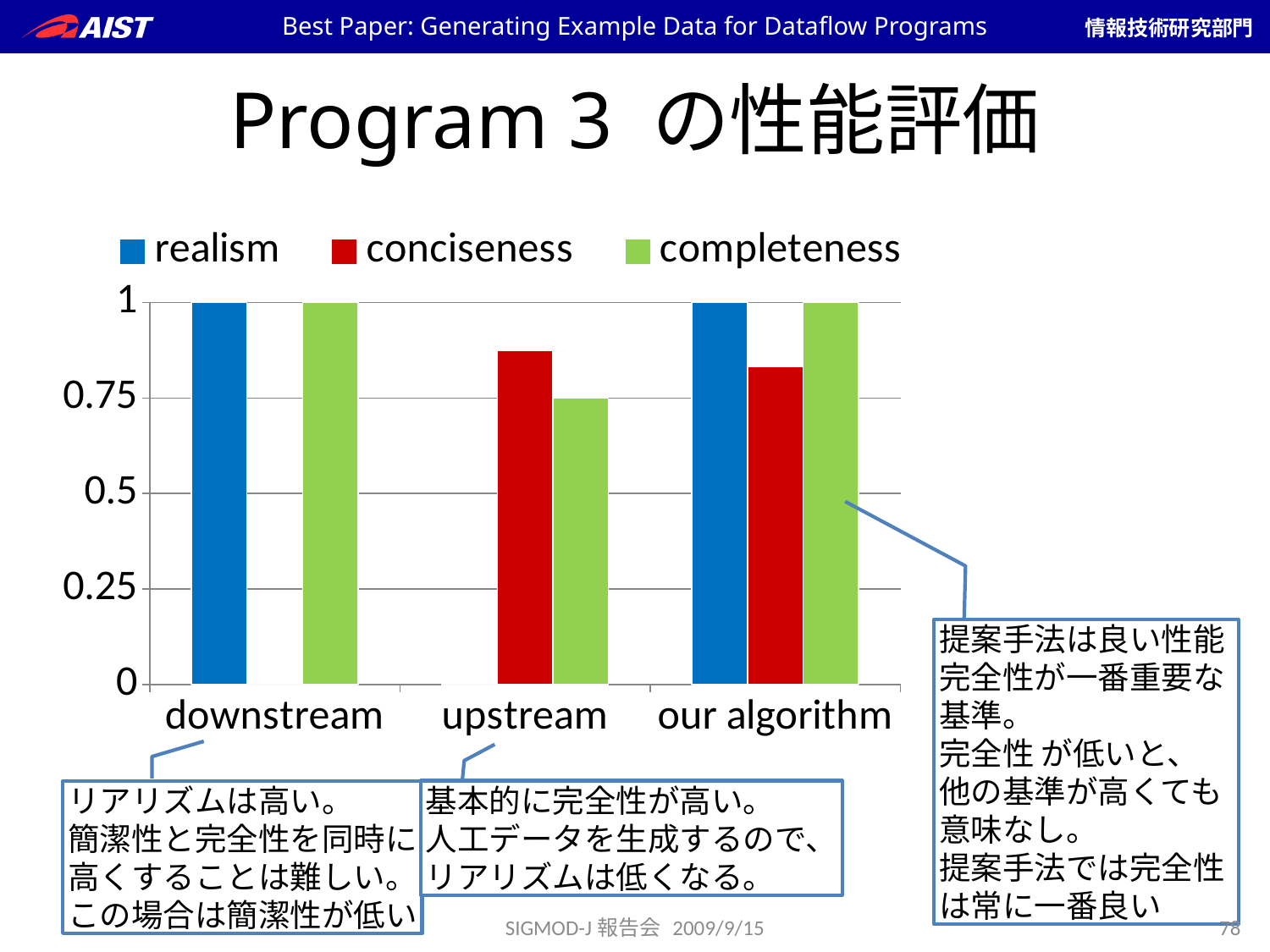
What is the realism value for our algorithm? 1 How many categories are shown on the x axis? 3 What is the realism value for downstream? 1 Is the conciseness value for our algorithm greater or less than 0.75? greater Is the completeness value for upstream greater or less than 1? less Which category has the lowest conciseness value? downstream Is the conciseness value for upstream greater or less than 0.75? greater What kind of chart is shown on the slide? bar chart What colour represents the completeness series in the legend? green Which has the larger completeness value, upstream or our algorithm? our algorithm What is the completeness value for our algorithm? 1 How many series does the legend list? 3